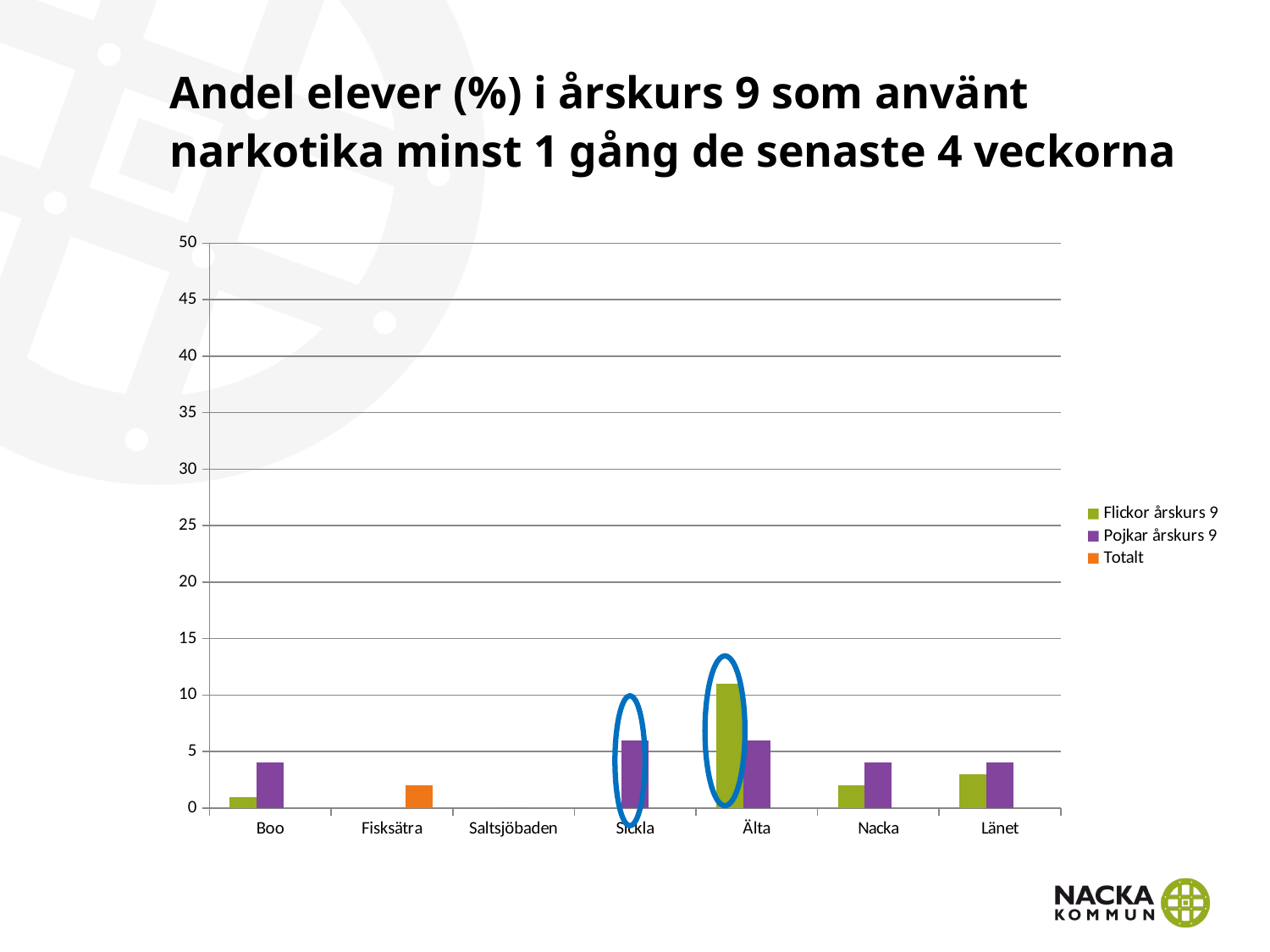
Which category has no bars at all? Saltsjöbaden How many categories are shown on the x axis? 7 Is the value for Flickor årskurs 9 in Älta greater or less than 10? greater In Boo, which is larger: Flickor årskurs 9 or Pojkar årskurs 9? Pojkar årskurs 9 Which category shows only a Totalt bar? Fisksätra What are the three legend entries of the chart? Flickor årskurs 9, Pojkar årskurs 9, Totalt What kind of chart is shown on the slide? bar chart In Älta, which is larger: Flickor årskurs 9 or Pojkar årskurs 9? Flickor årskurs 9 Which category has the highest value for Flickor årskurs 9? Älta Is the value for Pojkar årskurs 9 in Boo greater or less than 5? less How many series does the legend list? 3 Is the value for Flickor årskurs 9 in Länet greater or less than 5? less